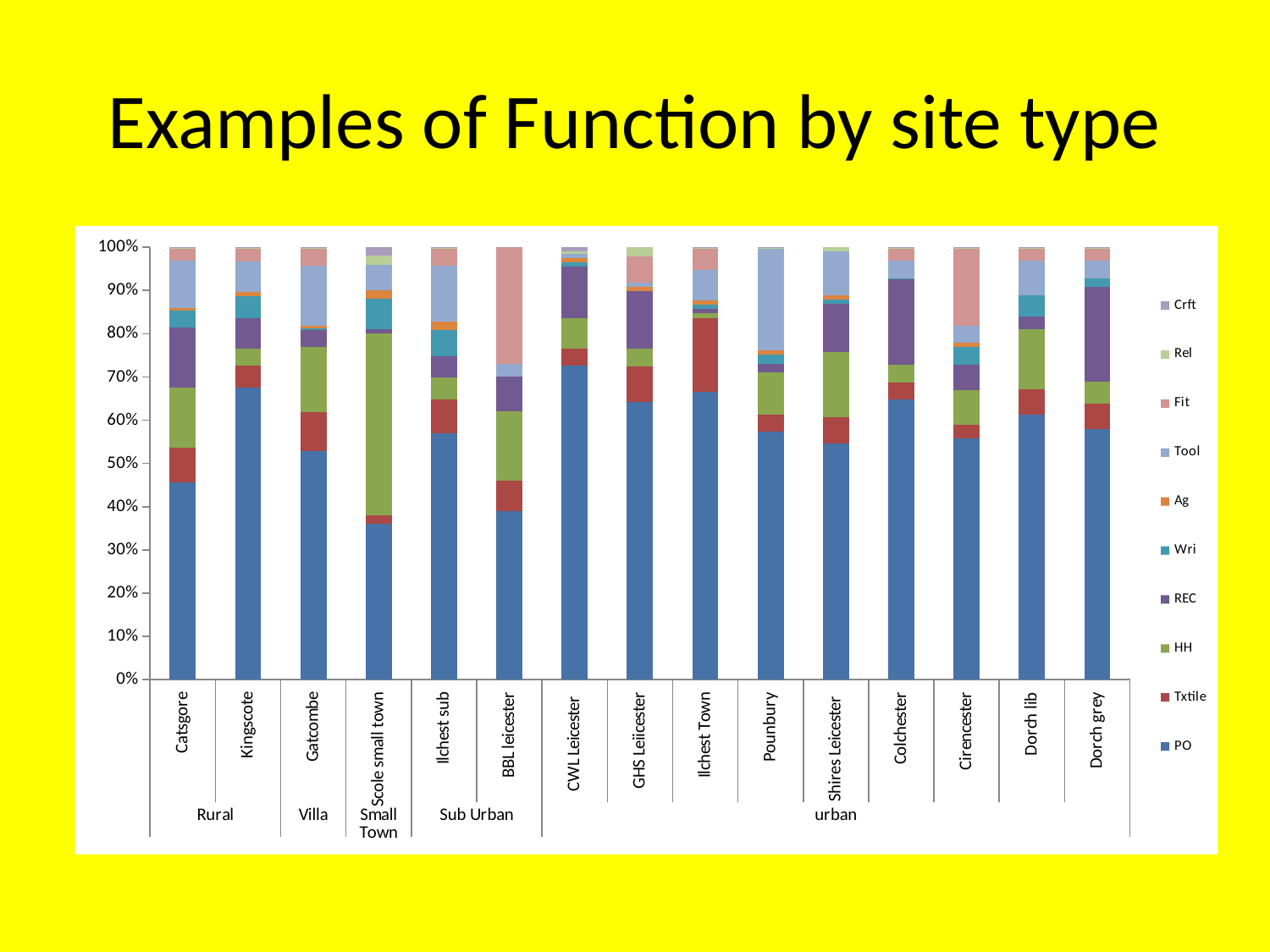
What kind of chart is shown on the slide? Stacked bar chart How many sites (bars) are plotted on the chart? 15 Is the PO share for CWL Leicester greater or less than 70%? greater Which site has the smallest PO share? Scole small town How many series does the legend list? 10 Is the PO share for Kingscote greater or less than 60%? greater Is the PO share for Catsgore greater or less than 50%? less What is the title of the slide? Examples of Function by site type Which site has a larger PO share, Kingscote or Gatcombe? Kingscote How many site-type groups are labelled along the x axis? 5 Which site has the largest PO share? CWL Leicester